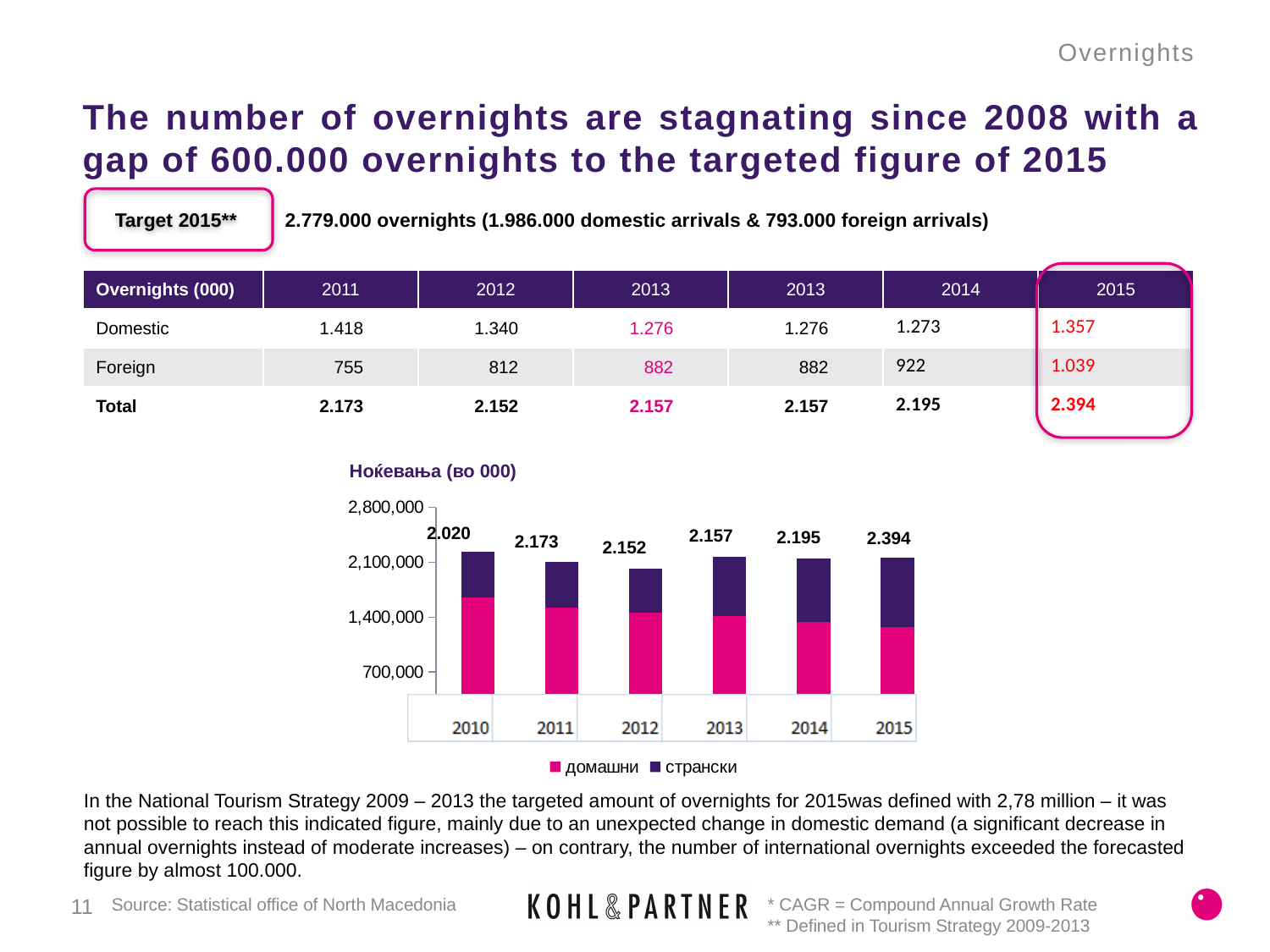
What is the total overnights value labelled for 2010 in the chart? 2.020 How many years are shown on the x axis of the chart? 6 What is the total overnights value labelled for 2015 in the chart? 2.394 Which year has the lowest total overnights in the chart? 2010 What kind of chart is shown on the slide? Stacked bar chart How many series does the chart's legend list? 2 Which year has the larger total overnights in the chart, 2011 or 2012? 2011 Do the total overnights in the chart rise or fall from 2012 to 2015? Rise Is the домашни (domestic) segment for 2014 in the chart greater or less than 1,400,000? less What is the difference between the total overnights labelled for 2015 and 2014 in the chart? 199 What is the total overnights value labelled for 2013 in the chart? 2.157 Which year has the highest total overnights in the chart? 2015